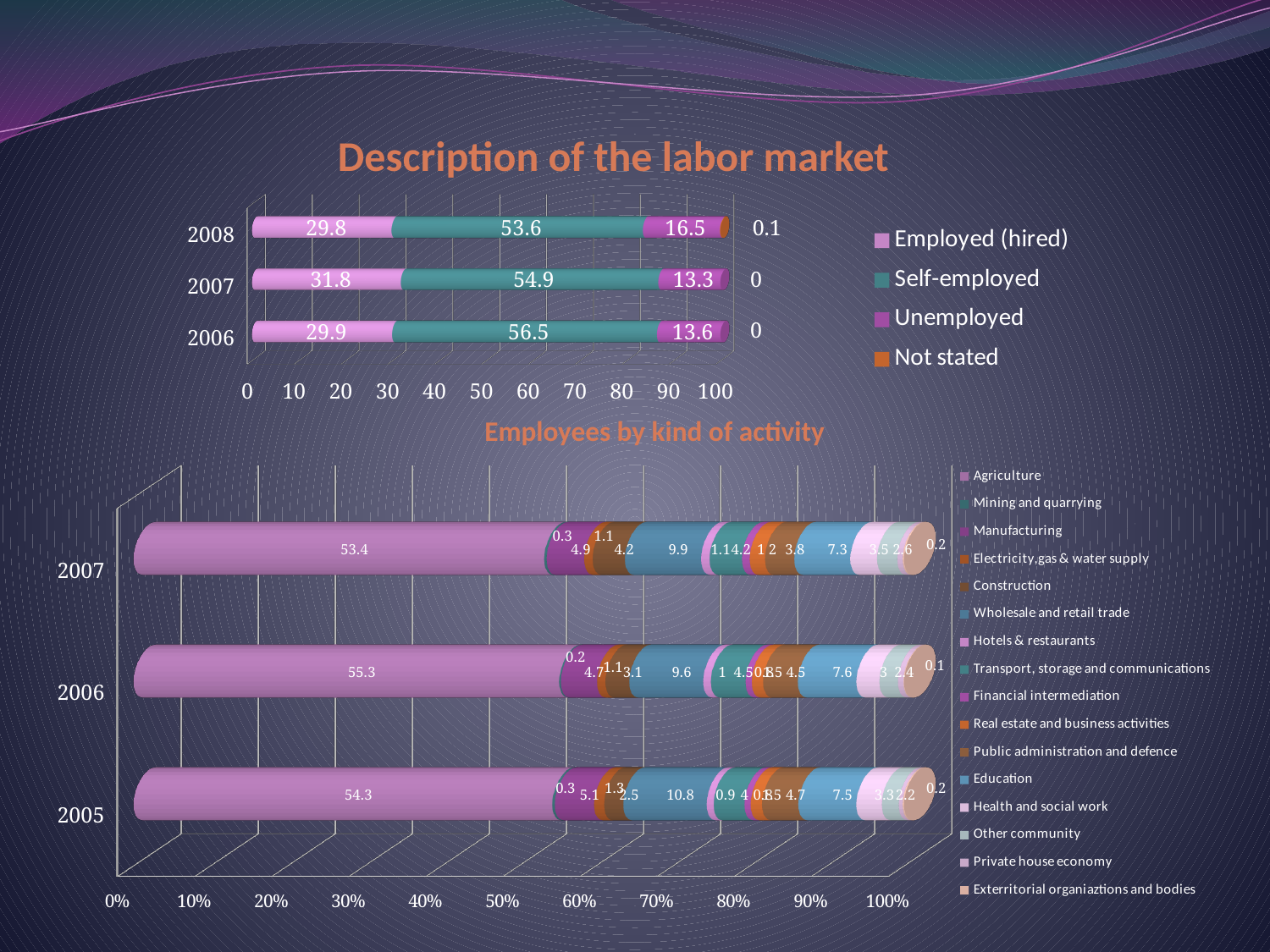
In the top chart, Description of the labor market, what is the Employed (hired) value for 2007? 31.8 In the top chart, Description of the labor market, what is the Unemployed value for 2008? 16.5 In the bottom chart, Employees by kind of activity, what is the Agriculture value for 2006? 55.3 In the top chart, Description of the labor market, what is the Not stated value for 2008? 0.1 In the top chart, Description of the labor market, how many series does the legend list? 4 What kind of chart is the bottom chart, Employees by kind of activity? Stacked bar chart In the bottom chart, Employees by kind of activity, is the Agriculture value for 2005 larger or smaller than the Agriculture value for 2006? smaller In the bottom chart, Employees by kind of activity, which year has the lowest Agriculture value? 2007 In the bottom chart, Employees by kind of activity, how many years are shown on the vertical axis? 3 In the top chart, Description of the labor market, what is the difference between the Unemployed values for 2008 and 2007? 3.2 In the top chart, Description of the labor market, which year has the highest Self-employed value? 2006 In the top chart, Description of the labor market, what is the Self-employed value for 2006? 56.5